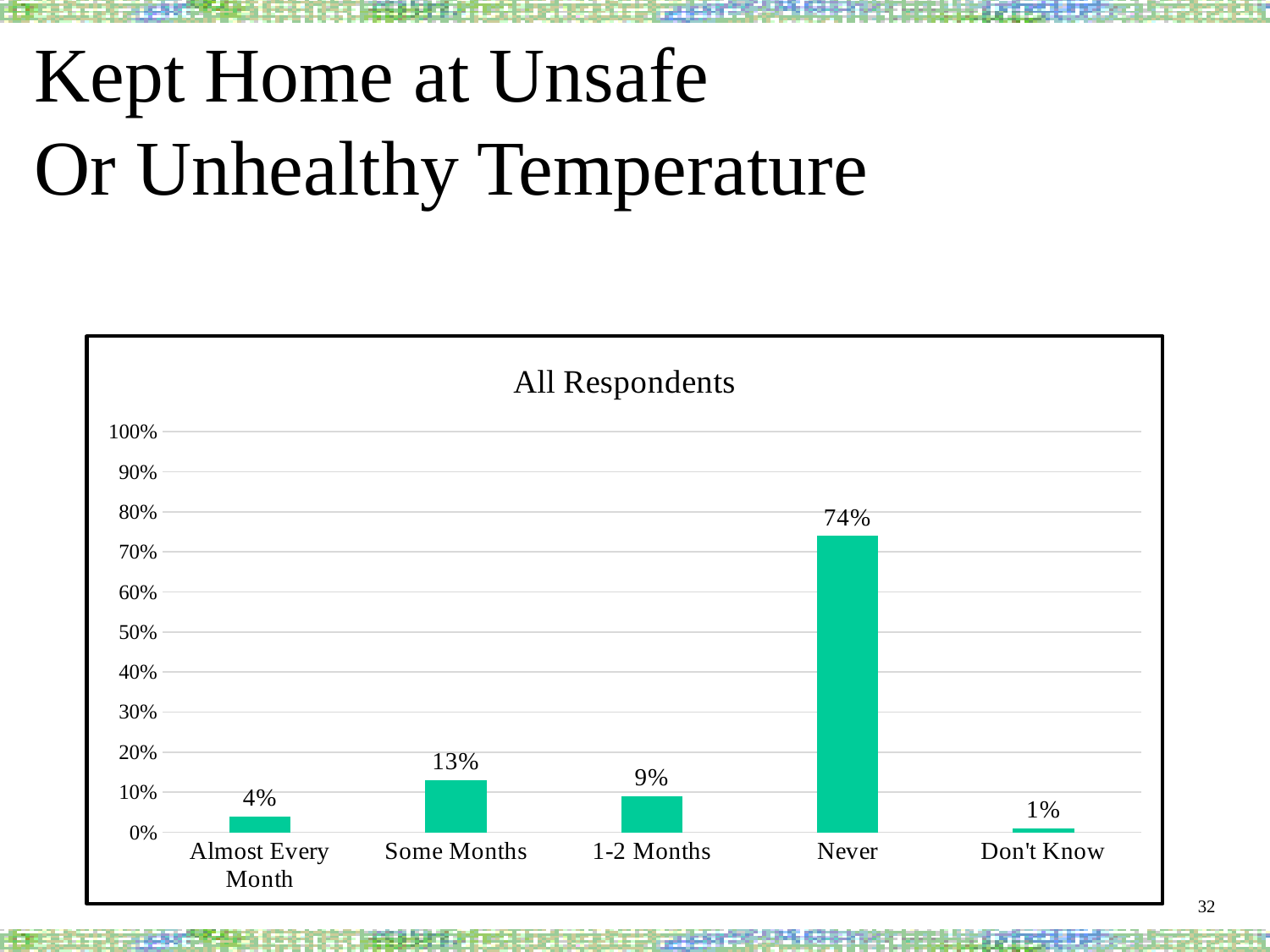
What is the difference between the values for Never and Some Months? 61% What is the value for Almost Every Month? 4% What is the value for Don't Know? 1% What is the value for Some Months? 13% What kind of chart is shown? bar chart Which category has the lowest value? Don't Know Which is larger, the value for Some Months or the value for 1-2 Months? Some Months Which category has the highest value? Never How many categories are shown on the x axis? 5 What is the value for Never? 74% What is the title of the chart? All Respondents Is the value for Never greater or less than 70%? greater